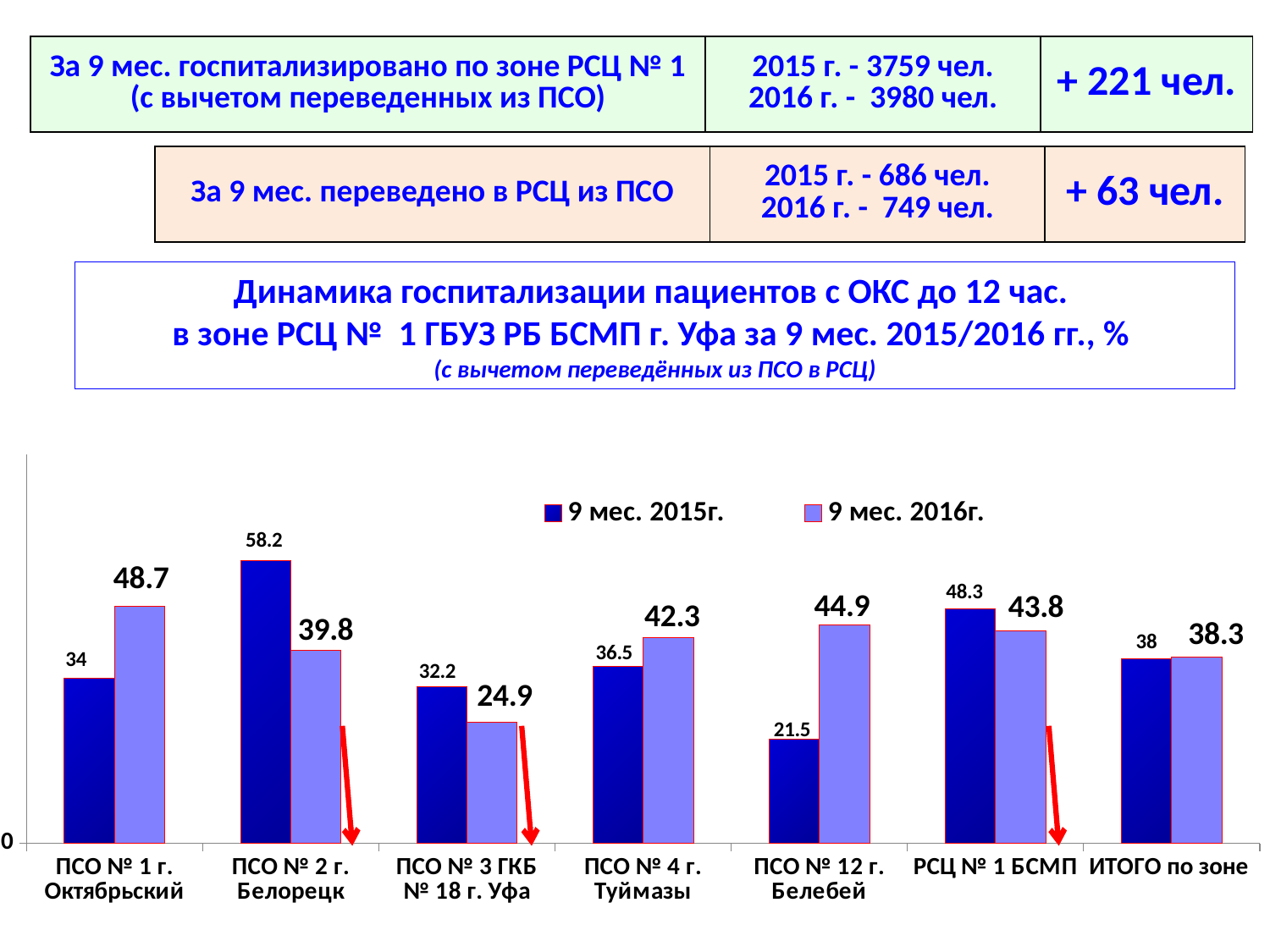
For РСЦ № 1 БСМП, which series has the larger value: 9 мес. 2015г. or 9 мес. 2016г.? 9 мес. 2015г. How many categories are shown on the x axis of the chart? 7 What is the difference between the 9 мес. 2016г. and 9 мес. 2015г. values for ПСО № 12 г. Белебей? 23.4 Which category has the highest value in the 9 мес. 2015г. series? ПСО № 2 г. Белорецк What is the value for ПСО № 1 г. Октябрьский in the 9 мес. 2016г. series? 48.7 What kind of chart is shown on the slide? Bar chart How many series does the chart legend list? 2 Which category has the lowest value in the 9 мес. 2016г. series? ПСО № 3 ГКБ № 18 г. Уфа What is the value for ИТОГО по зоне in the 9 мес. 2016г. series? 38.3 What is the difference between the 9 мес. 2015г. and 9 мес. 2016г. values for ПСО № 2 г. Белорецк? 18.4 What is the value for ПСО № 2 г. Белорецк in the 9 мес. 2015г. series? 58.2 What is the value for ПСО № 12 г. Белебей in the 9 мес. 2015г. series? 21.5